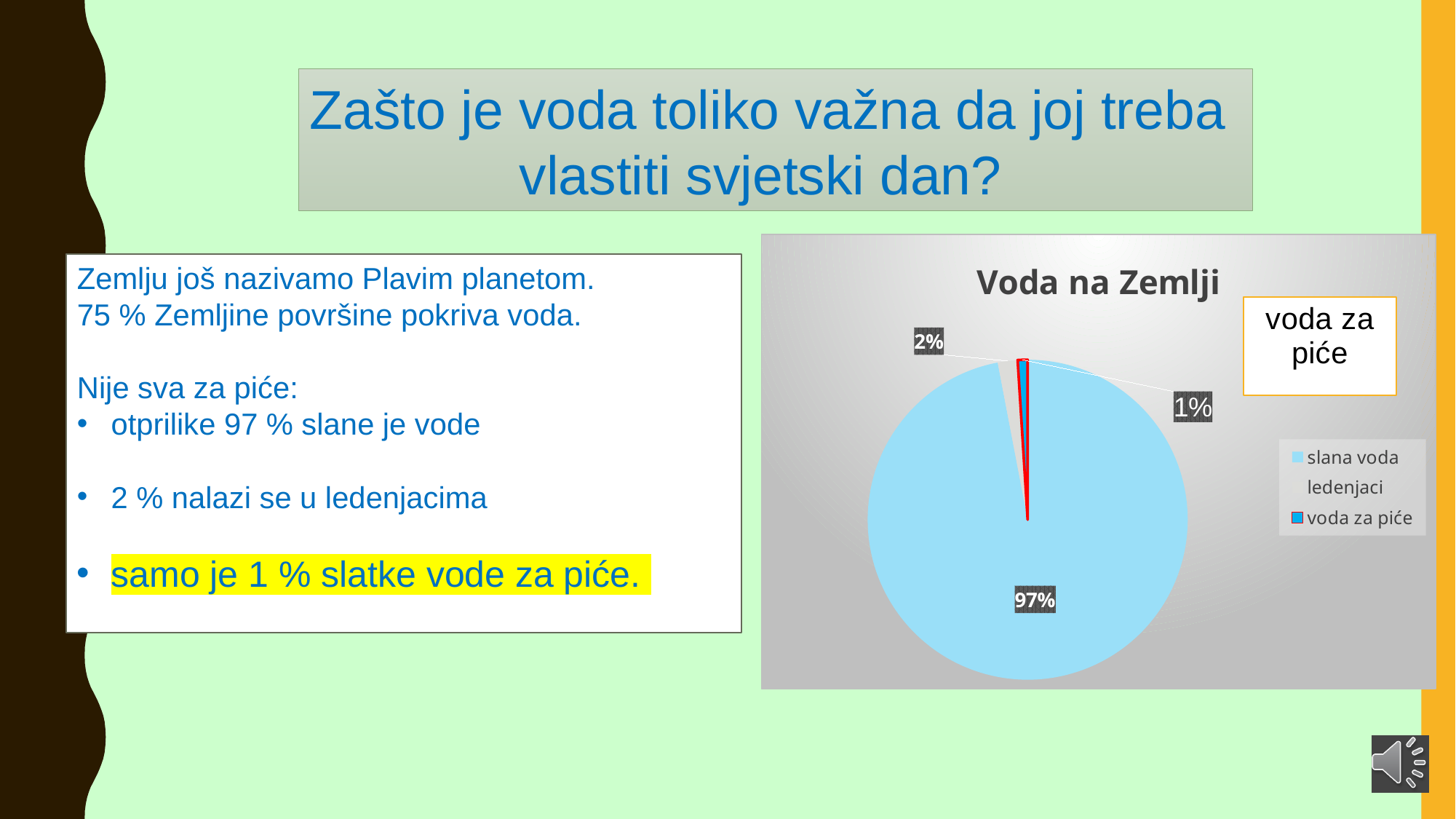
What share of the pie does "ledenjaci" take? 2% What colour is the "voda za piće" slice outlined in? red What share of the pie does "voda za piće" take? 1% What is the difference between the shares of "slana voda" and "ledenjaci"? 95% Which category has the largest slice of the pie? slana voda What is the title of the chart? Voda na Zemlji Which is larger, the share for "ledenjaci" or the share for "voda za piće"? ledenjaci How many slices does the pie chart have? 3 What share of the pie does "slana voda" take? 97% How many entries does the legend list? 3 What kind of chart is shown on the slide? pie chart Which category has the smallest slice of the pie? voda za piće